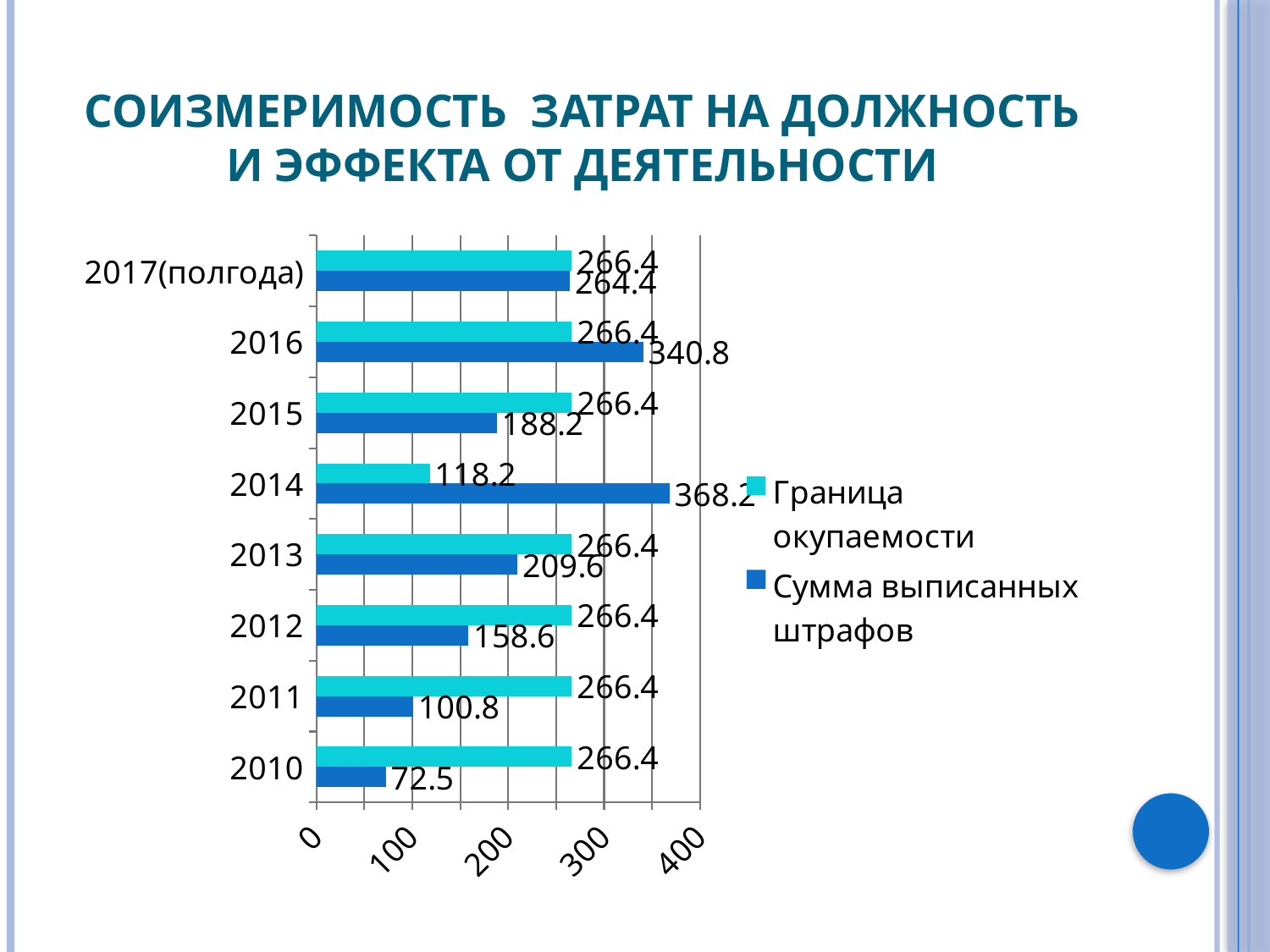
Which series is shown in dark blue in the legend? Сумма выписанных штрафов What is the difference between "Сумма выписанных штрафов" for 2016 and for 2015? 152.6 How many years (categories) are shown on the chart? 8 How many series does the legend list? 2 What kind of chart is shown on the slide? Bar chart In which year is "Сумма выписанных штрафов" the lowest? 2010 What is the value of "Сумма выписанных штрафов" for 2010? 72.5 Which is larger for 2013: "Граница окупаемости" or "Сумма выписанных штрафов"? Граница окупаемости In which year is "Сумма выписанных штрафов" the highest? 2014 What is the value of "Сумма выписанных штрафов" for 2017(полгода)? 264.4 What is the value of "Граница окупаемости" for 2014? 118.2 What is the value of "Сумма выписанных штрафов" for 2014? 368.2